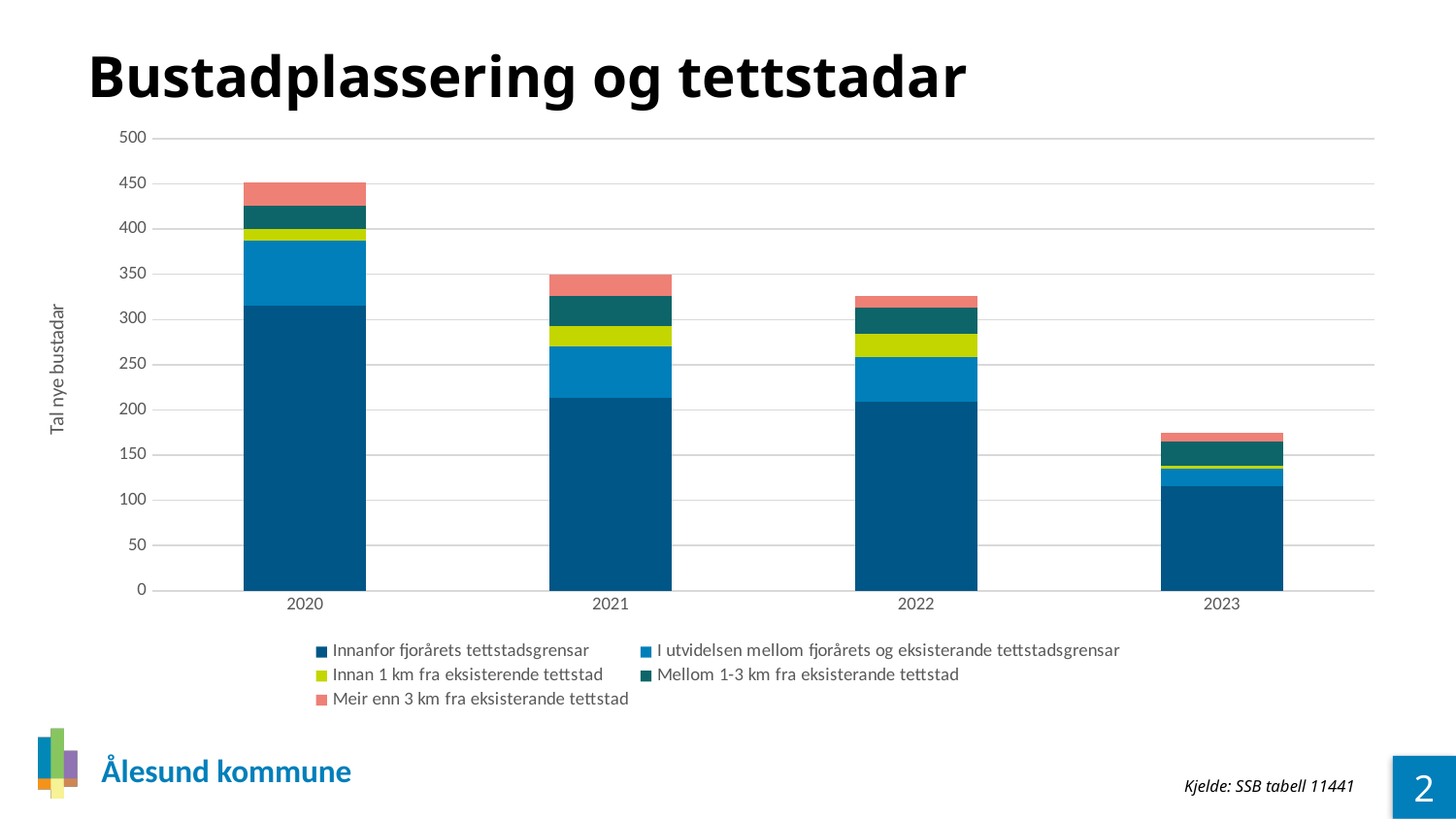
How many years are shown on the x axis of the chart? 4 How many series does the chart's legend list? 5 What kind of chart is shown on the slide? bar chart Which year has a larger total bar, 2020 or 2023? 2020 Is the total value for 2023 greater or less than 200? less Is the total value for 2021 greater or less than 300? greater What is the label on the vertical axis of the chart? Tal nye bustadar Is the total value for 2020 greater or less than 400? greater Do the total bar heights rise or fall from 2020 to 2023? fall Which year has the highest total number of new dwellings? 2020 Which year has the lowest total number of new dwellings? 2023